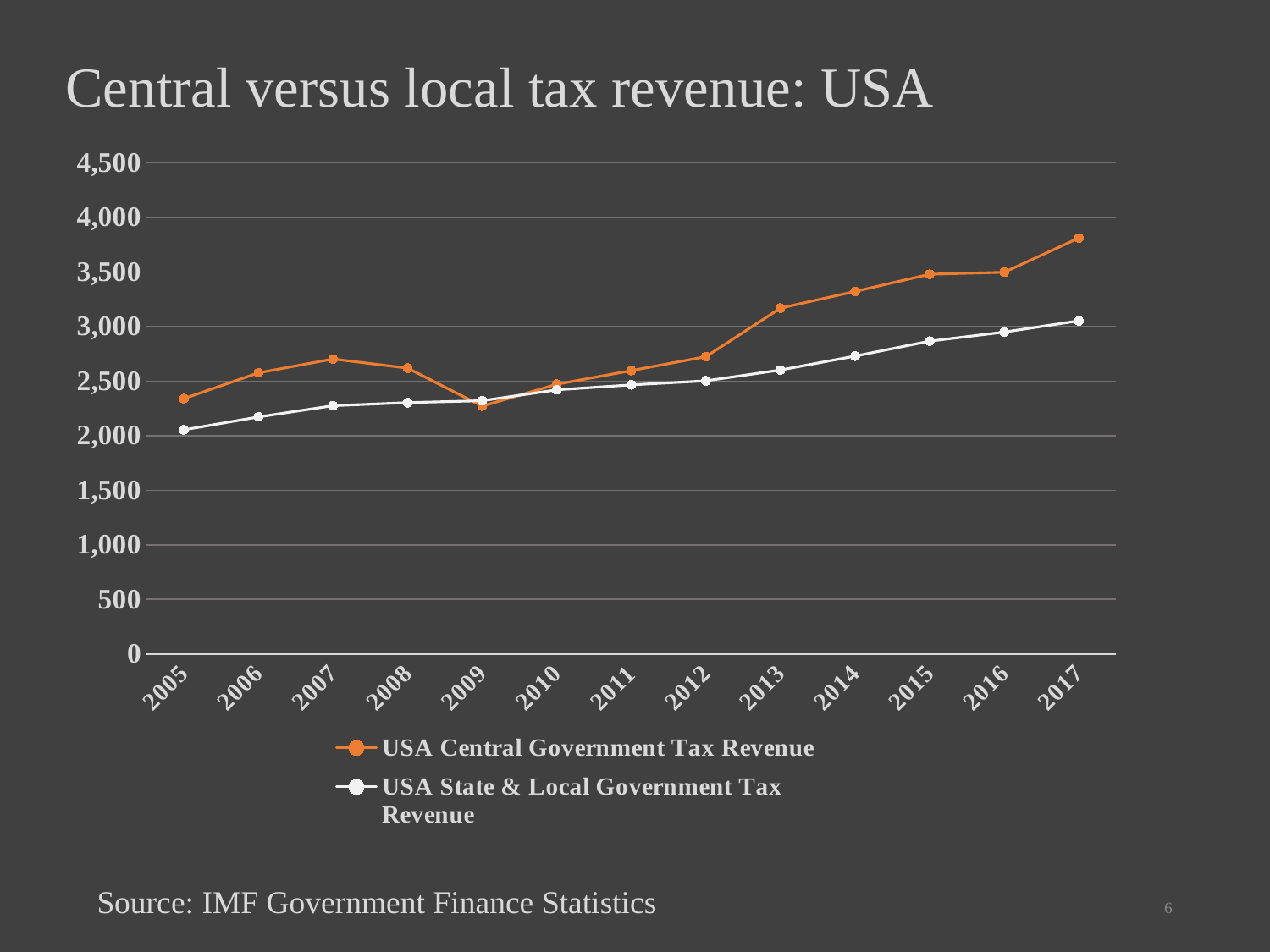
Is the value for USA Central Government Tax Revenue in 2017 greater or less than 3,500? greater In which year is USA Central Government Tax Revenue highest? 2017 Is the value for USA State & Local Government Tax Revenue in 2017 greater or less than 3,500? less What kind of chart is shown on the slide? line chart How many years are plotted along the x axis? 13 In 2014, which series has the larger value: USA Central Government Tax Revenue or USA State & Local Government Tax Revenue? USA Central Government Tax Revenue Is the value for USA Central Government Tax Revenue in 2013 greater or less than 3,000? greater In which year is USA State & Local Government Tax Revenue lowest? 2005 Which colour is used for the USA Central Government Tax Revenue line? orange Does USA State & Local Government Tax Revenue rise or fall from 2005 to 2017? rise How many series does the legend list? 2